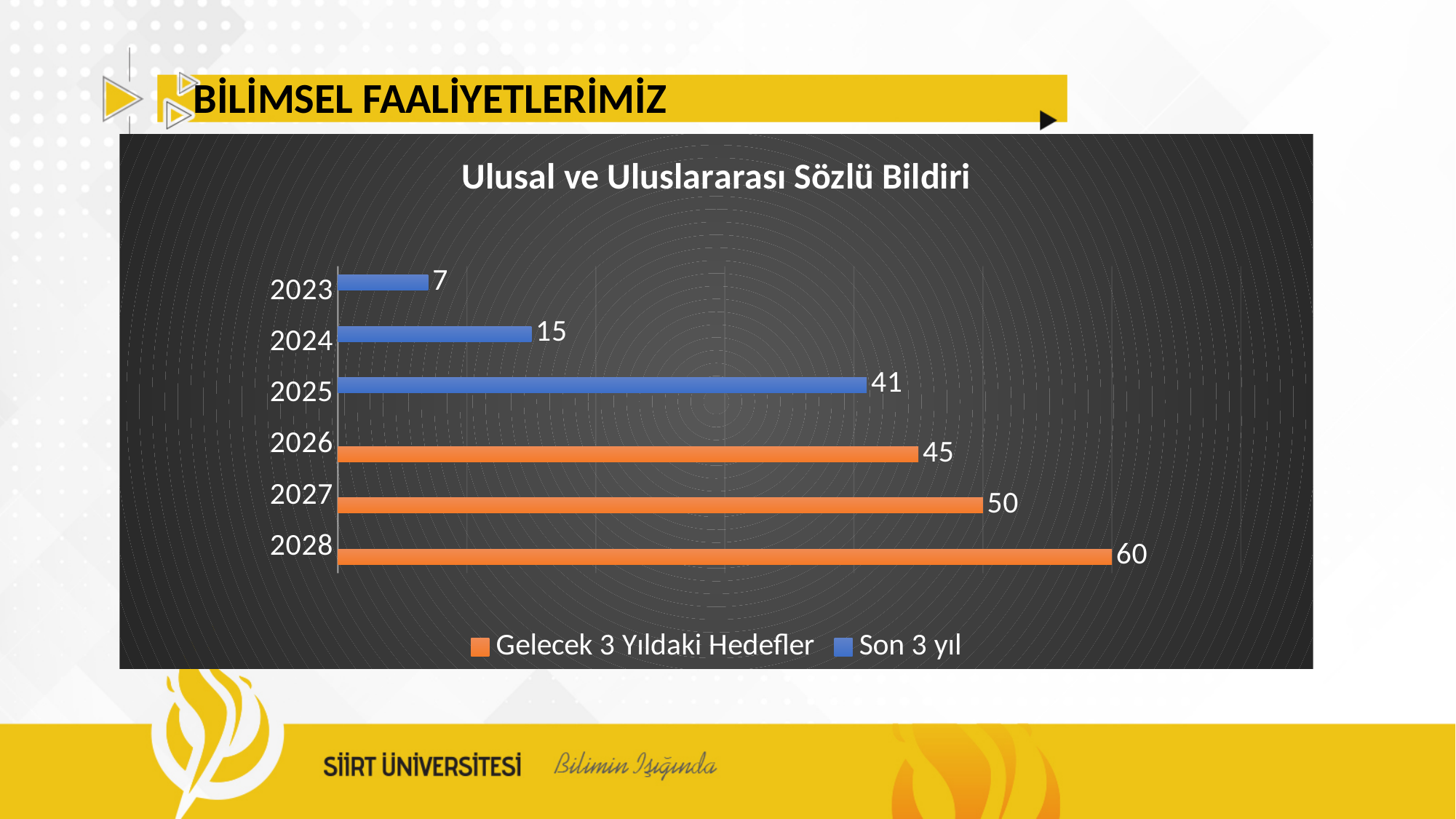
What kind of chart is shown on the slide? Bar chart What is the title of the chart? Ulusal ve Uluslararası Sözlü Bildiri What is the value for 2025 in the chart? 41 What is the value for 2023 in the chart? 7 What is the value for 2028 in the chart? 60 What is the difference between the values for 2025 and 2024? 26 Which year has the lowest value in the chart? 2023 Which is larger, the value for 2024 or the value for 2026? 2026 What is the difference between the values for 2027 and 2026? 5 Which year has the highest value in the chart? 2028 How many years are shown on the chart? 6 How many series does the legend list? 2